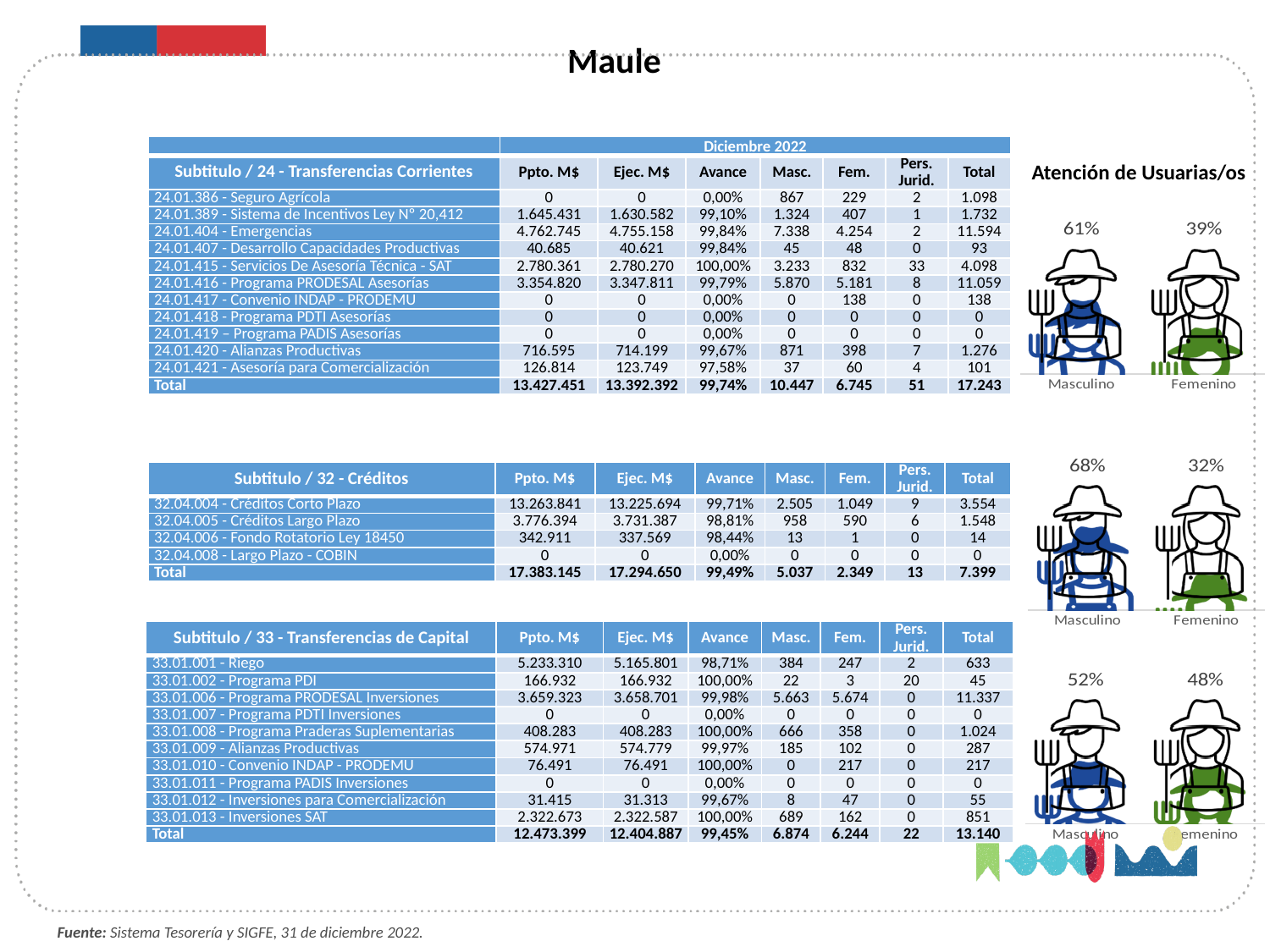
In the middle pictogram (next to the Subtítulo 32 table), what percentage is shown for Femenino? 32% In the top 'Atención de Usuarias/os' pictogram (next to the Subtítulo 24 table), what percentage is shown for Femenino? 39% In the middle pictogram, what is the difference between the Masculino and Femenino percentages? 36% In the top 'Atención de Usuarias/os' pictogram (next to the Subtítulo 24 table), what percentage is shown for Masculino? 61% In the bottom pictogram (next to the Subtítulo 33 table), what percentage is shown for Femenino? 48% Across the three pictograms on the right, which one shows the highest Masculino percentage? The middle one (68%) What is the title above the pictograms on the right side of the slide? Atención de Usuarias/os In the top pictogram, which category has the higher share, Masculino or Femenino? Masculino In the bottom pictogram (next to the Subtítulo 33 table), what percentage is shown for Masculino? 52% In the middle pictogram (next to the Subtítulo 32 table), what percentage is shown for Masculino? 68% How many categories does each pictogram on the right show? 2 In the bottom pictogram, what is the difference between the Masculino and Femenino percentages? 4%